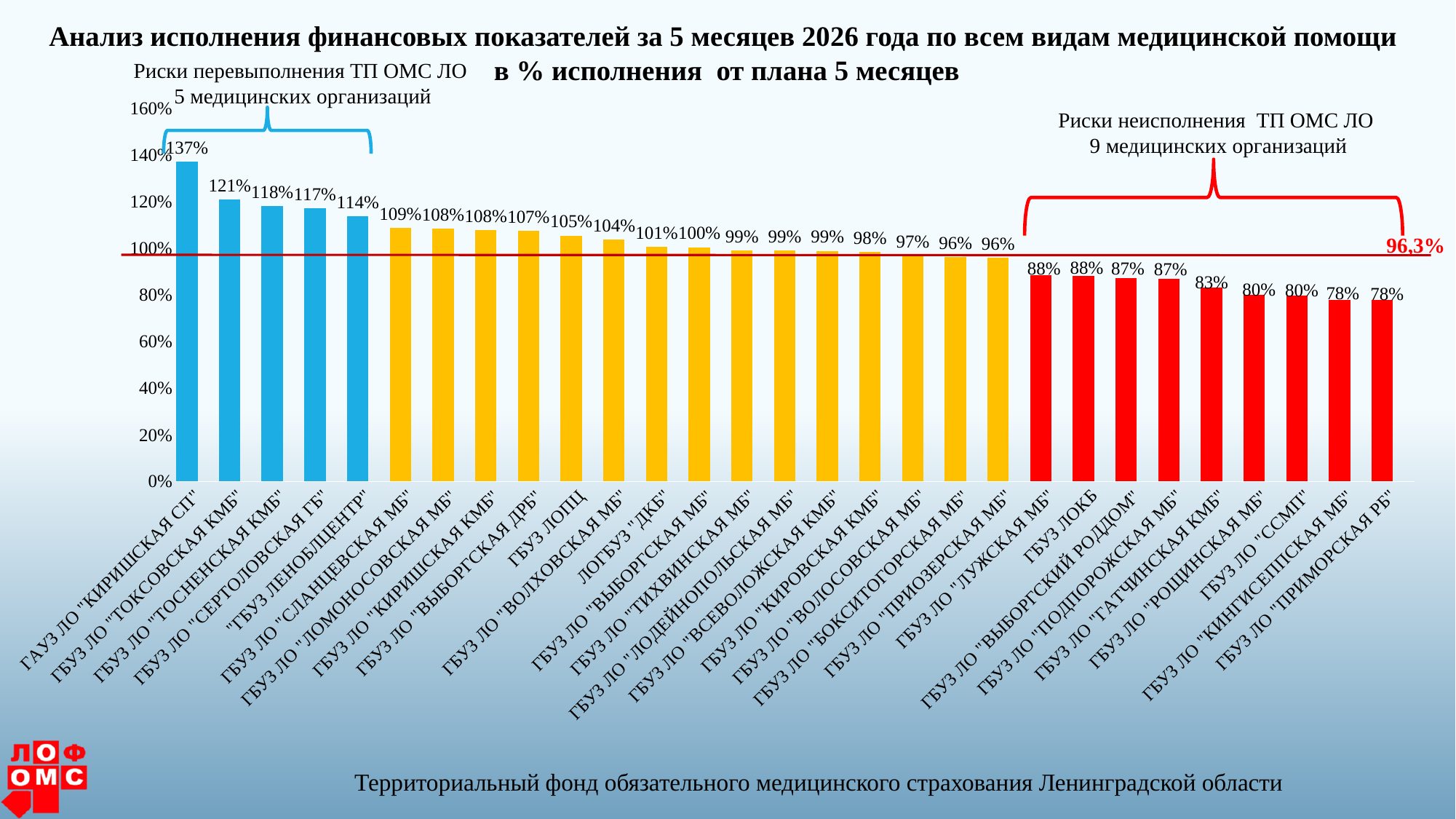
Is the value for ГБУЗ ЛО "ССМП" greater or less than 100%? less What value is labelled on the horizontal reference line across the chart? 96,3% What is the value for ГБУЗ ЛОПЦ? 105% How many organisations (bars) are shown on the chart? 29 What is the value for ГБУЗ ЛО "ГАТЧИНСКАЯ КМБ"? 83% Which is larger, the value for ГБУЗ ЛО "СЛАНЦЕВСКАЯ МБ" or the value for ГБУЗ ЛО "ВОЛХОВСКАЯ МБ"? ГБУЗ ЛО "СЛАНЦЕВСКАЯ МБ" How many medical organisations are marked as having risks of non-fulfilment (Риски неисполнения) of ТП ОМС ЛО? 9 What is the value for ГАУЗ ЛО "КИРИШСКАЯ СП"? 137% Do the values rise or fall from left to right along the x axis? fall What is the difference between the values for ГБУЗ ЛО "ТОКСОВСКАЯ КМБ" and ГБУЗ ЛО "ЛУЖСКАЯ МБ"? 33% What kind of chart is shown on the slide? bar chart Which organisation has the highest value on the chart? ГАУЗ ЛО "КИРИШСКАЯ СП"